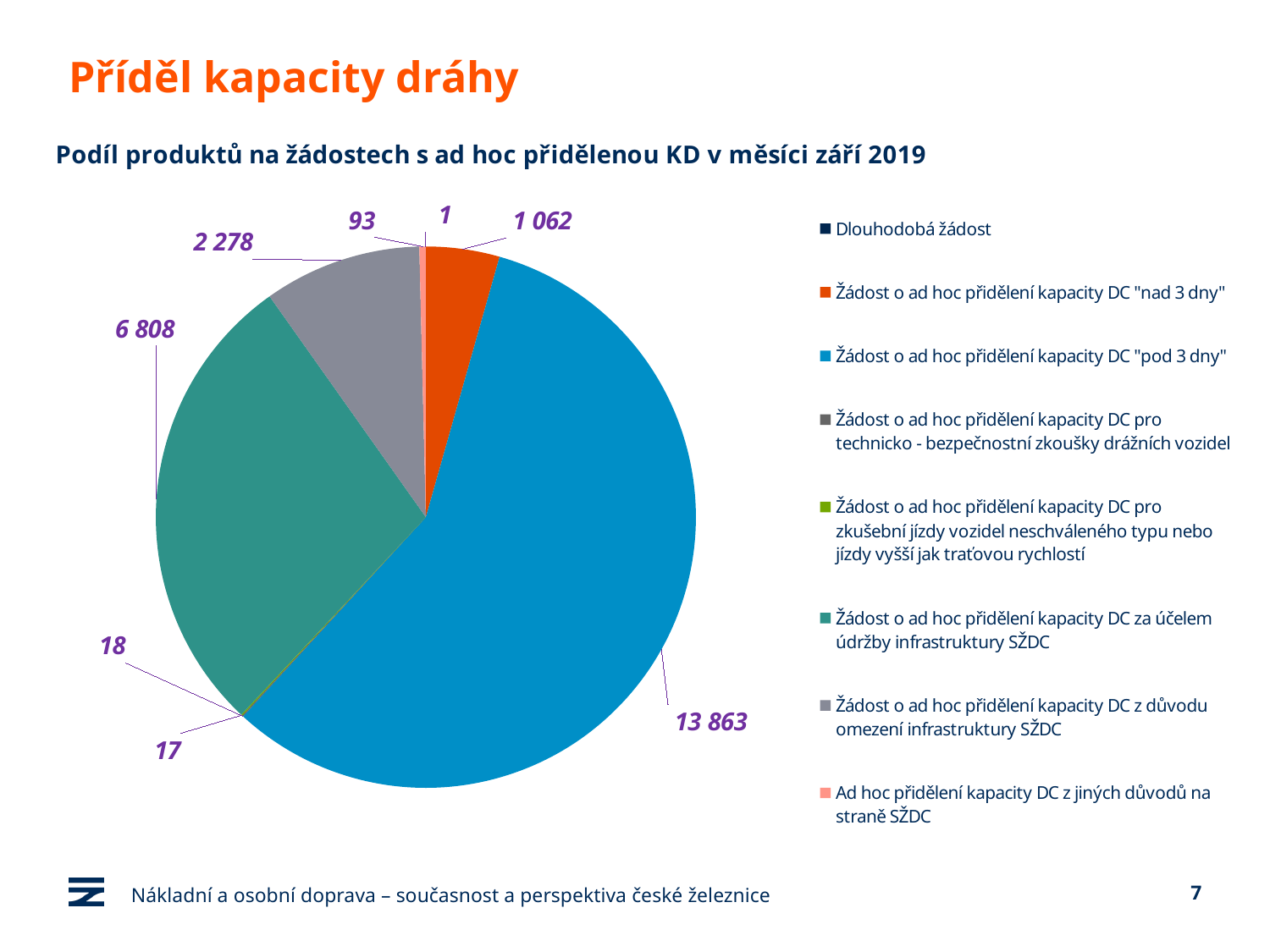
What is the value for 'Ad hoc přidělení kapacity DC z jiných důvodů na straně SŽDC'? 93 What is the value for 'Žádost o ad hoc přidělení kapacity DC "nad 3 dny"'? 1 062 What is the difference between the values for 'pod 3 dny' (13 863) and 'za účelem údržby infrastruktury SŽDC' (6 808)? 7 055 Which category has the largest slice of the pie? Žádost o ad hoc přidělení kapacity DC "pod 3 dny" What is the value for 'Žádost o ad hoc přidělení kapacity DC "pod 3 dny"'? 13 863 What is the value for 'Dlouhodobá žádost'? 1 What is the value for 'Žádost o ad hoc přidělení kapacity DC z důvodu omezení infrastruktury SŽDC'? 2 278 What type of chart is shown on the slide? pie chart Which is larger: the value for 'za účelem údržby infrastruktury SŽDC' or for 'z důvodu omezení infrastruktury SŽDC'? za účelem údržby infrastruktury SŽDC How many entries does the legend list? 8 What is the value for 'Žádost o ad hoc přidělení kapacity DC za účelem údržby infrastruktury SŽDC'? 6 808 Which category has the smallest value? Dlouhodobá žádost